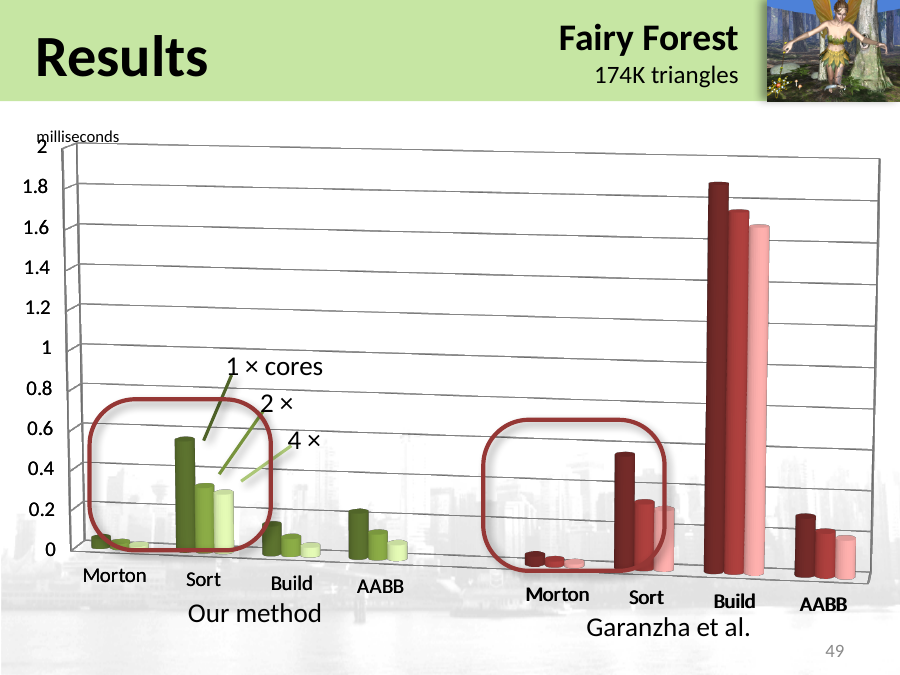
Which category has the lowest bars for Garanzha et al.? Morton Is the 1 × cores Build value for Garanzha et al. greater or less than 1.6? greater What kind of chart is shown on the slide? bar chart Is the 1 × cores Build value for Our method greater or less than 0.2? less What unit is shown on the vertical axis? milliseconds Is the 4 × cores Build value for Garanzha et al. greater or less than 1.4? greater Which is larger, the Build value for Our method or the Build value for Garanzha et al.? Garanzha et al. Which category has the tallest bars for Garanzha et al.? Build Which category has the tallest bars for Our method? Sort How many core-count series (1 × cores, 2 ×, 4 ×) are plotted for each category? 3 How many categories are plotted for Our method? 4